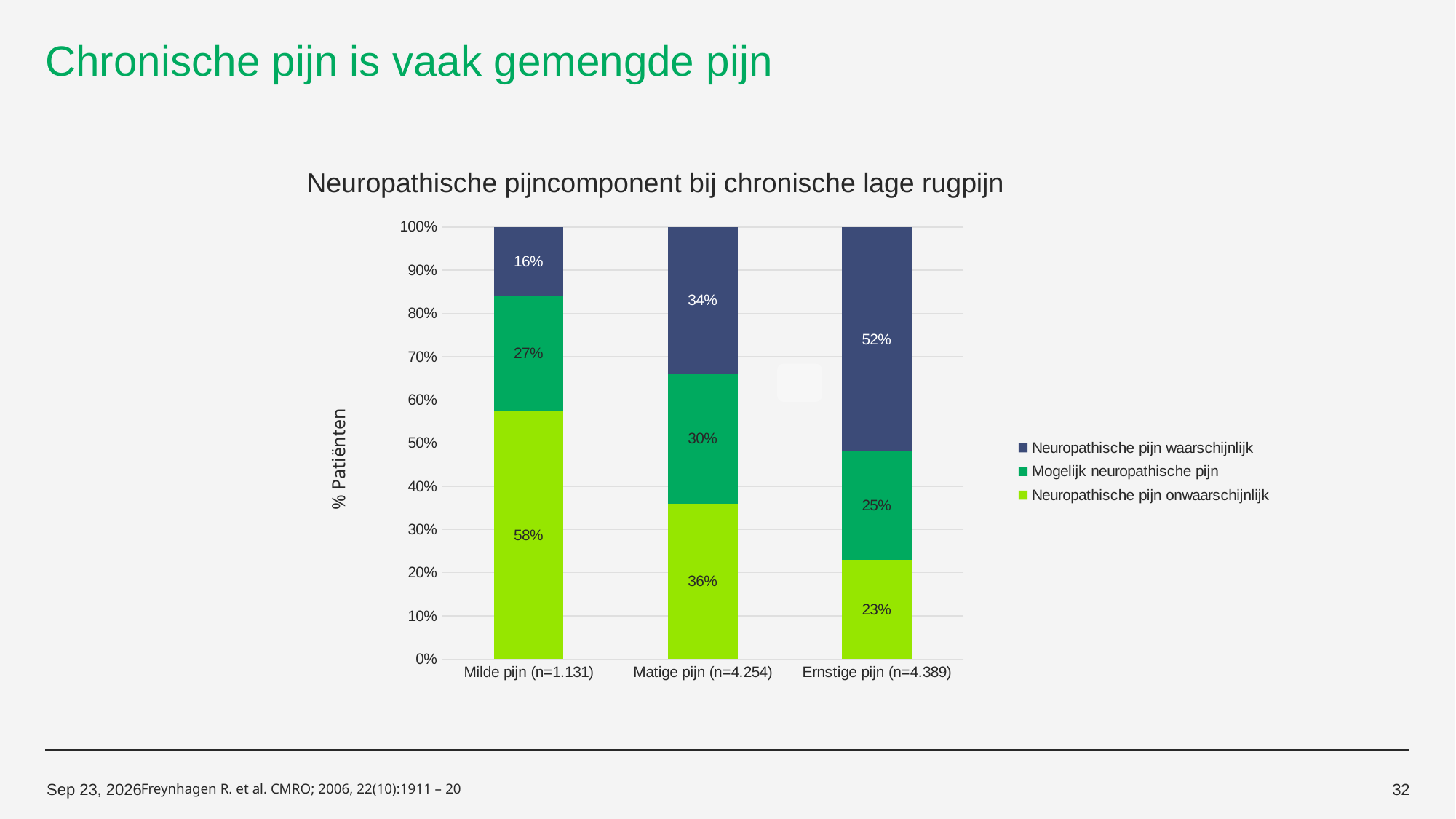
What is the value for 'Neuropathische pijn onwaarschijnlijk' in the 'Milde pijn (n=1.131)' bar? 58% What is the value for 'Mogelijk neuropathische pijn' in the 'Matige pijn (n=4.254)' bar? 30% How many series does the legend list? 3 Which is larger: 'Mogelijk neuropathische pijn' for 'Milde pijn (n=1.131)' or for 'Ernstige pijn (n=4.389)'? Milde pijn (n=1.131) What is the difference between the 'Neuropathische pijn waarschijnlijk' values for 'Ernstige pijn (n=4.389)' and 'Milde pijn (n=1.131)'? 36% Which category has the highest value for 'Neuropathische pijn waarschijnlijk'? Ernstige pijn (n=4.389) Which category has the lowest value for 'Neuropathische pijn onwaarschijnlijk'? Ernstige pijn (n=4.389) Do the values for 'Neuropathische pijn waarschijnlijk' rise or fall from 'Milde pijn' to 'Ernstige pijn'? Rise What kind of chart is shown on the slide? Stacked bar chart What is the value for 'Neuropathische pijn waarschijnlijk' in the 'Ernstige pijn (n=4.389)' bar? 52% How many categories are shown on the x axis? 3 What is the title of the chart? Neuropathische pijncomponent bij chronische lage rugpijn